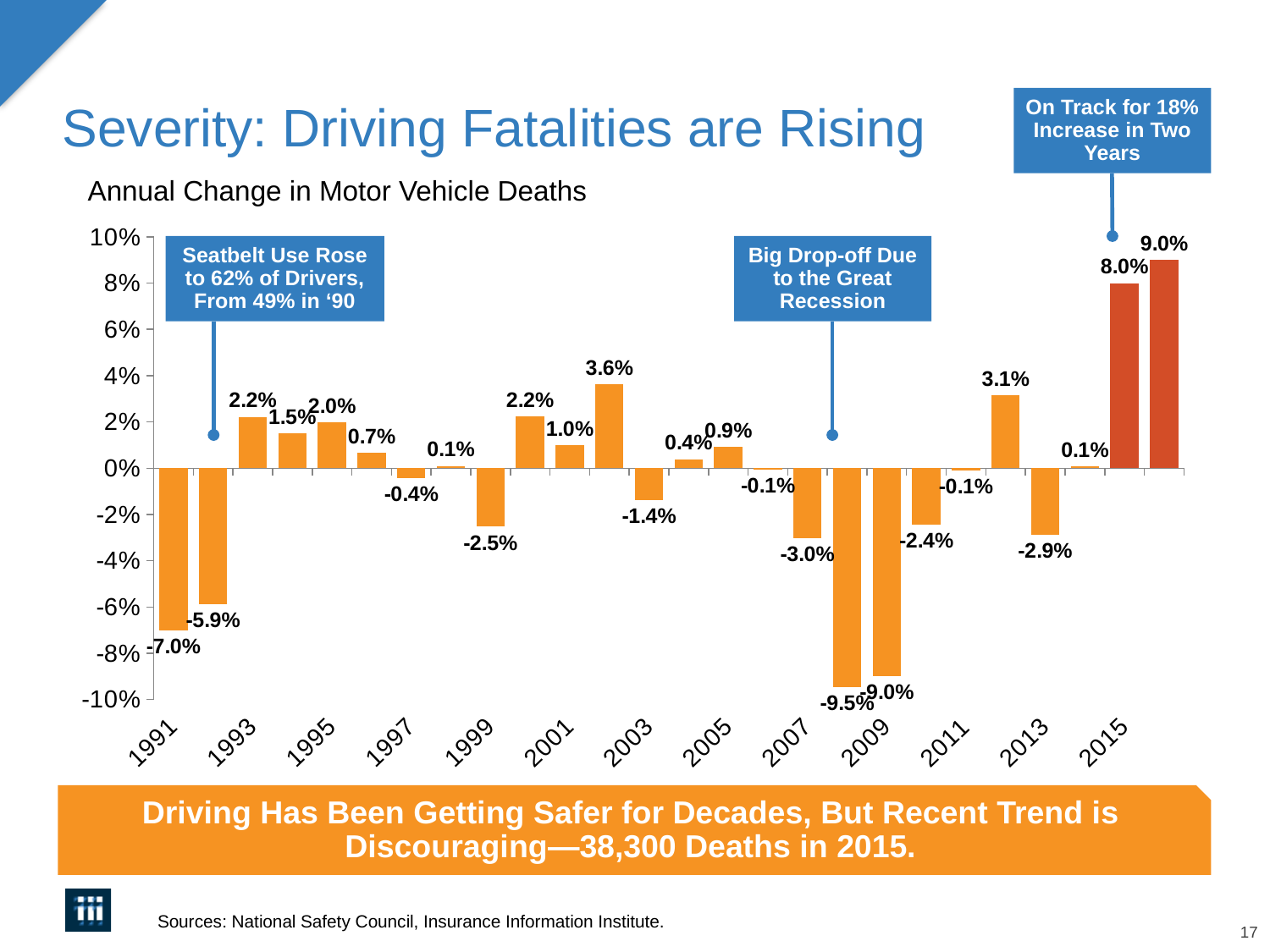
What is the annual change in motor vehicle deaths for 2009? -9.0% Which year has the larger annual change, 1993 or 2011? 1993 Is the value for 2007 greater or less than -2%? less What kind of chart is shown on the slide? bar chart Do the values rise or fall from 2013 to 2015? rise What is the title of the chart? Annual Change in Motor Vehicle Deaths What is the annual change in motor vehicle deaths for 1991? -7.0% What is the annual change in motor vehicle deaths for 2015? 8.0% What is the lowest annual change value shown on the chart? -9.5% What is the annual change in motor vehicle deaths for 2013? -2.9% What is the difference between the values for 2005 and 2003? 2.3 percentage points What is the highest annual change value shown on the chart? 9.0%